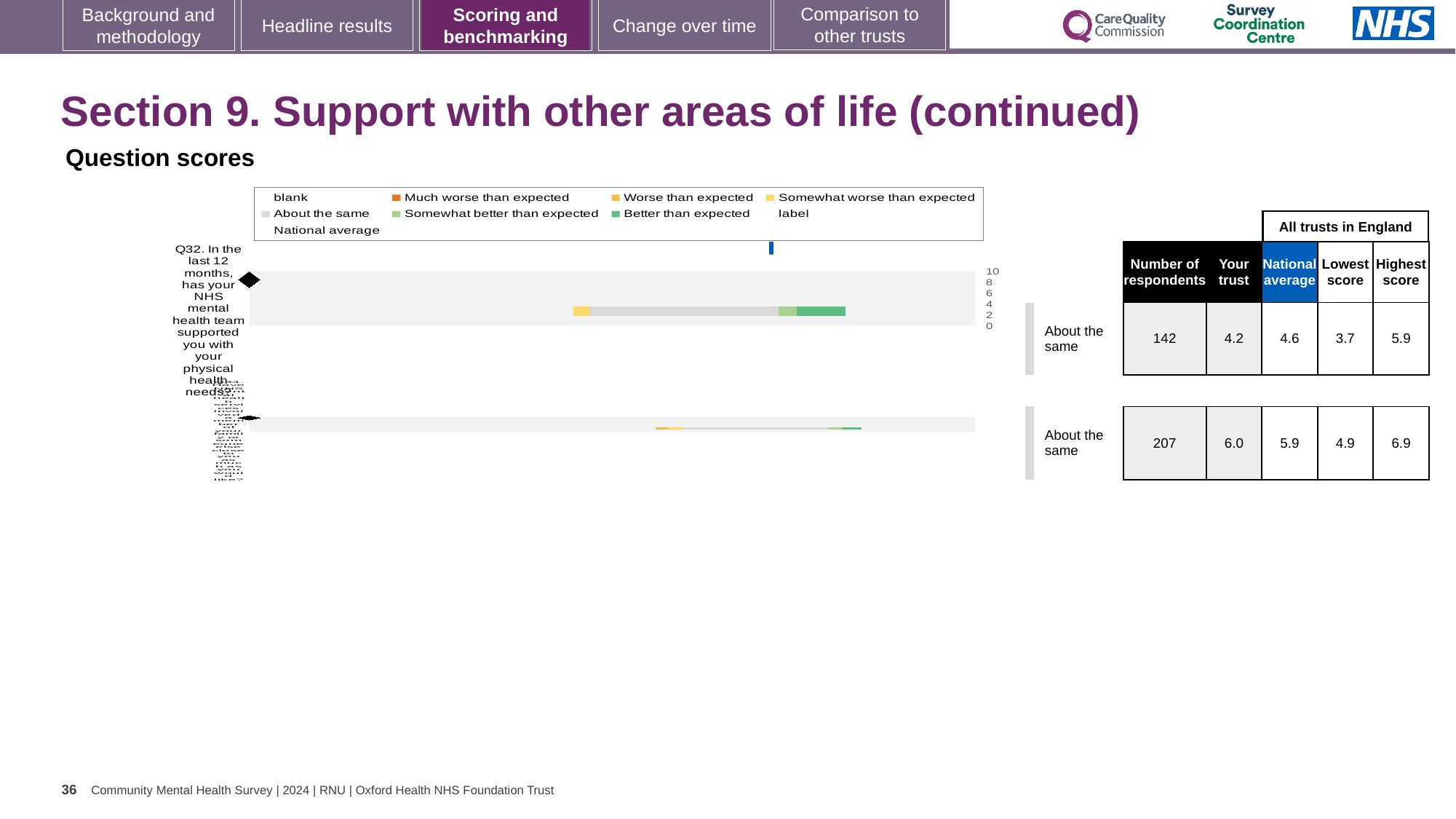
What kind of chart is used to show the question scores on this slide? bar chart How many entries does the chart legend list? 9 For Q32, which is larger: the trust's score or the national average? national average What is the lowest score among all trusts in England for Q32? 3.7 What is the 'Your trust' score for Q32 (support with physical health needs)? 4.2 How many respondents answered Q32? 142 How many question rows are plotted in the chart? 2 What is the highest score among all trusts in England for Q32? 5.9 For Q32, how much higher is the national average than the trust's score? 0.4 What benchmark category is shown for Q32? About the same What is the national average score for Q32? 4.6 For Q32, what is the difference between the highest and lowest scores among all trusts in England? 2.2